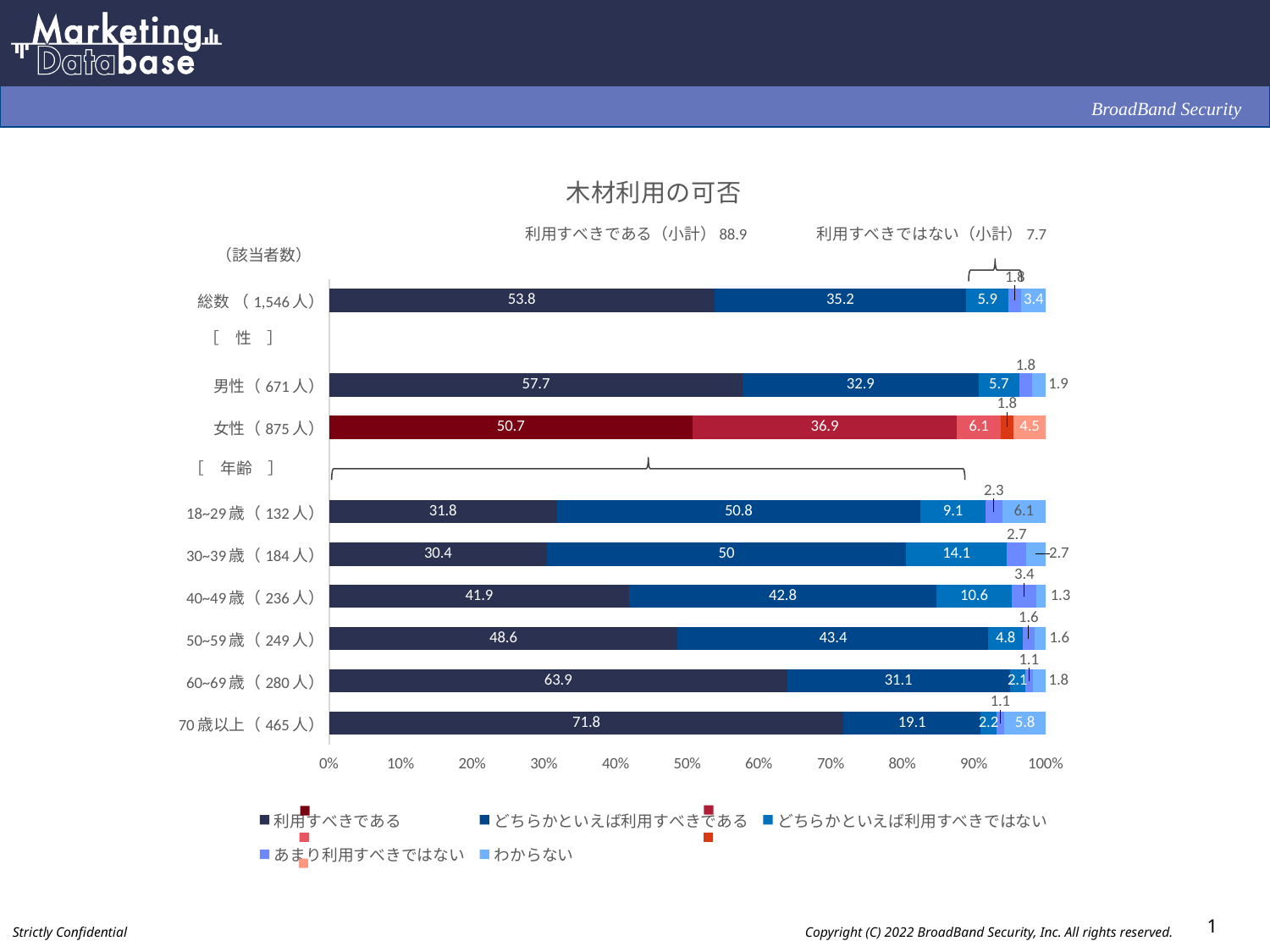
What is the value of 利用すべきである for 総数 (1,546人)? 53.8 What is the difference between the 利用すべきである values for 男性 (671人) and 女性 (875人)? 7 How many series does the legend list? 5 What is the value of わからない for 70歳以上 (465人)? 5.8 What is the 利用すべきである (小計) value shown above the chart? 88.9 Which category has the highest value for 利用すべきである? 70歳以上 (465人) What is the value of どちらかといえば利用すべきである for 女性 (875人)? 36.9 Which is larger, the どちらかといえば利用すべきである value for 18~29歳 (132人) or for 50~59歳 (249人)? 18~29歳 (132人) Which category has the lowest value for 利用すべきである? 30~39歳 (184人) What is the value of どちらかといえば利用すべきではない for 30~39歳 (184人)? 14.1 What type of chart is shown on the slide? Stacked bar chart What is the title of the chart? 木材利用の可否